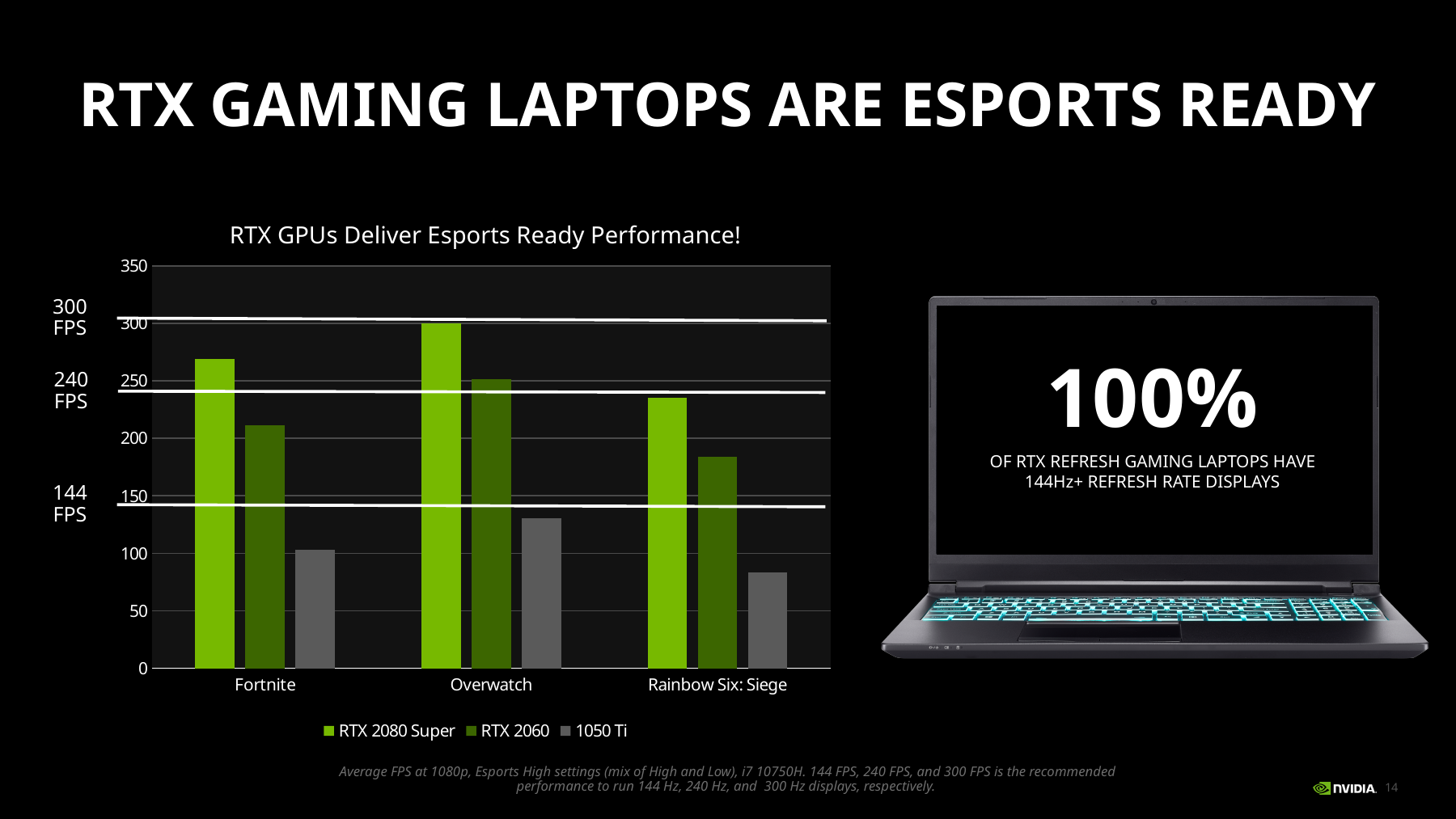
For which game is the RTX 2080 Super bar the highest? Overwatch Which is larger: the RTX 2060 value for Fortnite or the RTX 2060 value for Rainbow Six: Siege? Fortnite Is the 1050 Ti value for Fortnite greater or less than 150? less What kind of chart is shown on the slide? bar chart Is the RTX 2080 Super value for Fortnite greater or less than 250? greater For which game is the 1050 Ti bar the lowest? Rainbow Six: Siege What is the title of the chart? RTX GPUs Deliver Esports Ready Performance! Is the RTX 2060 value for Overwatch greater or less than 200? greater How many series does the chart legend list? 3 How many games are shown on the x axis of the chart? 3 Which series is shown in grey in the chart? 1050 Ti